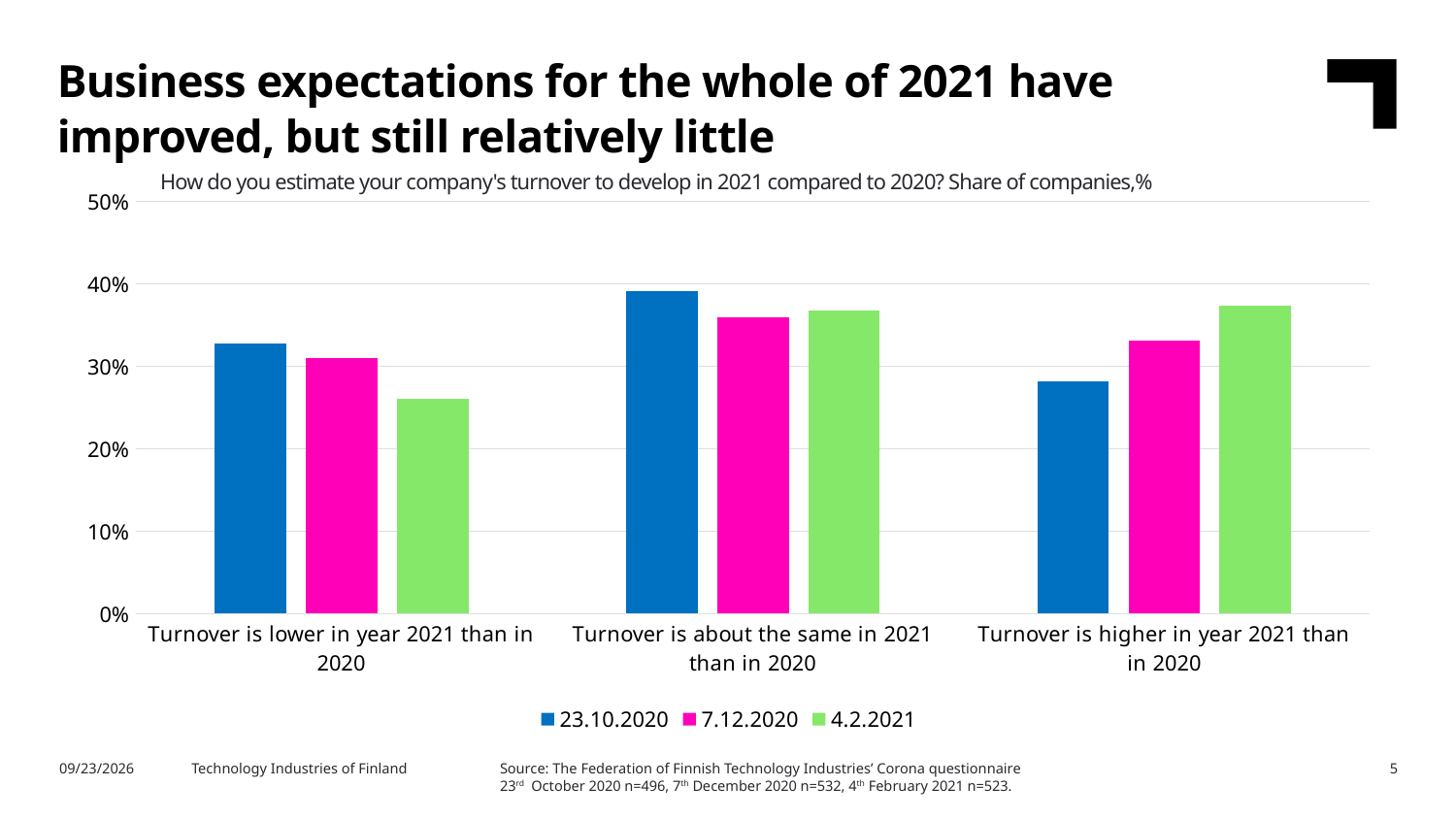
For the 23.10.2020 series, which category has the highest value? Turnover is about the same in 2021 than in 2020 What kind of chart is shown on the slide? bar chart In the category "Turnover is lower in year 2021 than in 2020", which is larger: the value for 23.10.2020 or for 4.2.2021? 23.10.2020 How many series does the legend list? 3 In the category "Turnover is higher in year 2021 than in 2020", which is larger: the value for 23.10.2020 or for 4.2.2021? 4.2.2021 Is the value for 23.10.2020 in the category "Turnover is about the same in 2021 than in 2020" greater or less than 30%? greater For the 4.2.2021 series, which category has the lowest value? Turnover is lower in year 2021 than in 2020 How many categories are shown on the x axis? 3 Is the value for 4.2.2021 in the category "Turnover is lower in year 2021 than in 2020" greater or less than 30%? less In the category "Turnover is lower in year 2021 than in 2020", do the values rise or fall from 23.10.2020 to 4.2.2021? fall Is the value for 4.2.2021 in the category "Turnover is higher in year 2021 than in 2020" greater or less than 30%? greater Which colour represents the 4.2.2021 series in the legend? green